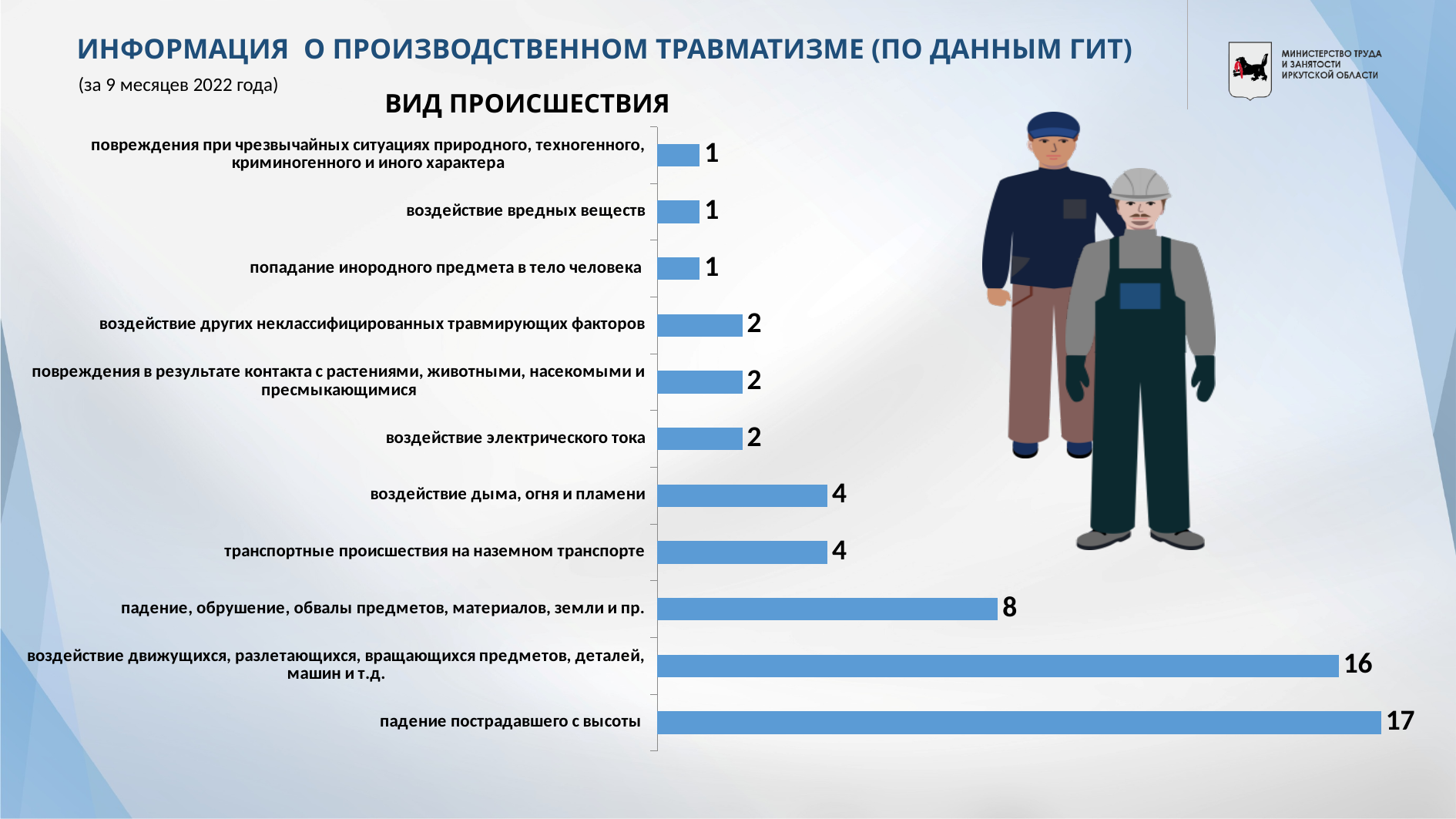
What is the value for "воздействие дыма, огня и пламени"? 4 What is the value for "воздействие движущихся, разлетающихся, вращающихся предметов, деталей, машин и т.д."? 16 What is the value for "воздействие электрического тока"? 2 How many categories have a value of 1? 3 What kind of chart is shown on the slide? bar chart How many categories are shown in the chart? 11 What is the difference between the values for "падение пострадавшего с высоты" and "падение, обрушение, обвалы предметов, материалов, земли и пр."? 9 What is the value for "падение, обрушение, обвалы предметов, материалов, земли и пр."? 8 What is the value for "падение пострадавшего с высоты"? 17 What is the title of the chart? ВИД ПРОИСШЕСТВИЯ Which is larger: the value for "воздействие дыма, огня и пламени" or the value for "воздействие электрического тока"? воздействие дыма, огня и пламени Which category has the highest value? падение пострадавшего с высоты